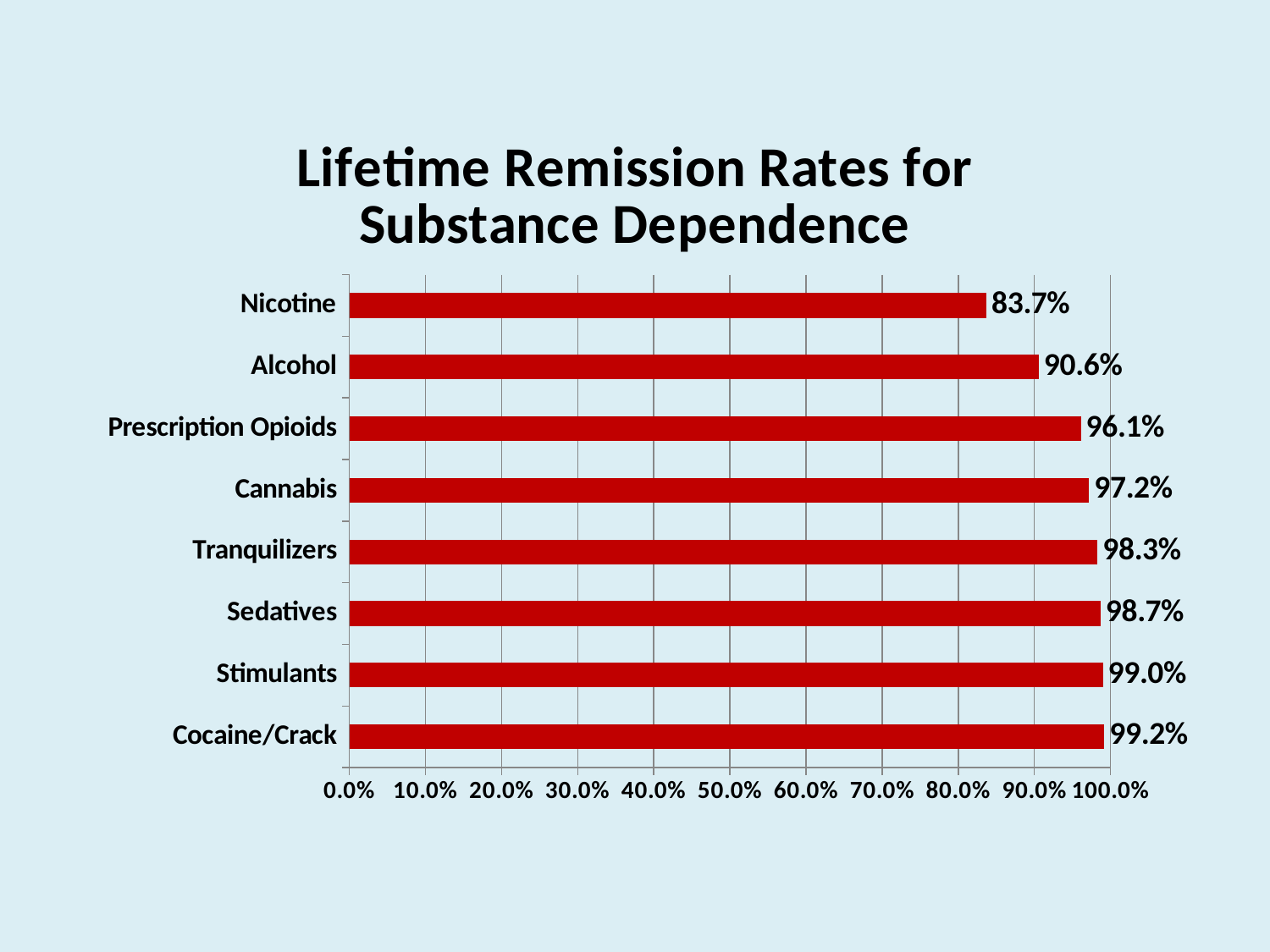
What is the lifetime remission rate for Alcohol? 90.6% How many substances are shown in the chart? 8 What is the lifetime remission rate for Nicotine? 83.7% Which has a higher lifetime remission rate, Alcohol or Prescription Opioids? Prescription Opioids Which substance has the lowest lifetime remission rate? Nicotine What kind of chart is shown on the slide? Bar chart What is the lifetime remission rate for Prescription Opioids? 96.1% What is the title of the chart? Lifetime Remission Rates for Substance Dependence What is the lifetime remission rate for Cocaine/Crack? 99.2% What is the difference between the remission rates for Cocaine/Crack and Cannabis? 2.0% Which substance has the highest lifetime remission rate? Cocaine/Crack What is the difference between the remission rates for Alcohol and Nicotine? 6.9%